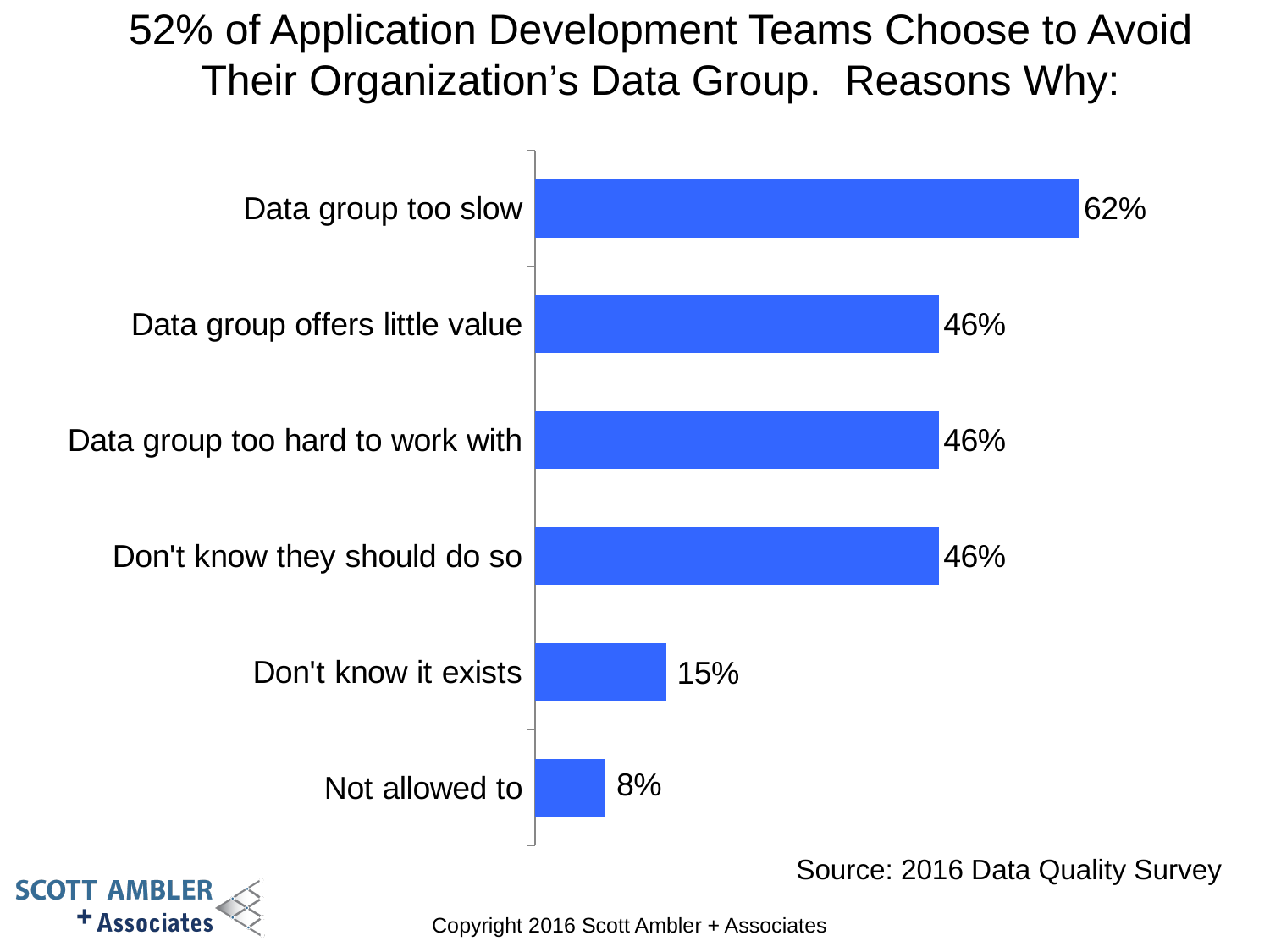
What is the difference between "Don't know it exists" and "Not allowed to"? 7% Which is larger: "Don't know they should do so" or "Don't know it exists"? Don't know they should do so How many reasons are shown in the chart? 6 What kind of chart is shown on the slide? Bar chart What is the value for "Not allowed to"? 8% What percentage is shown for "Data group too slow"? 62% What percentage is shown for "Data group offers little value"? 46% What is the difference between "Data group too slow" and "Data group too hard to work with"? 16% Which reason has the lowest percentage? Not allowed to What source is cited for the chart data? 2016 Data Quality Survey Which reason has the highest percentage? Data group too slow What is the value for "Don't know it exists"? 15%